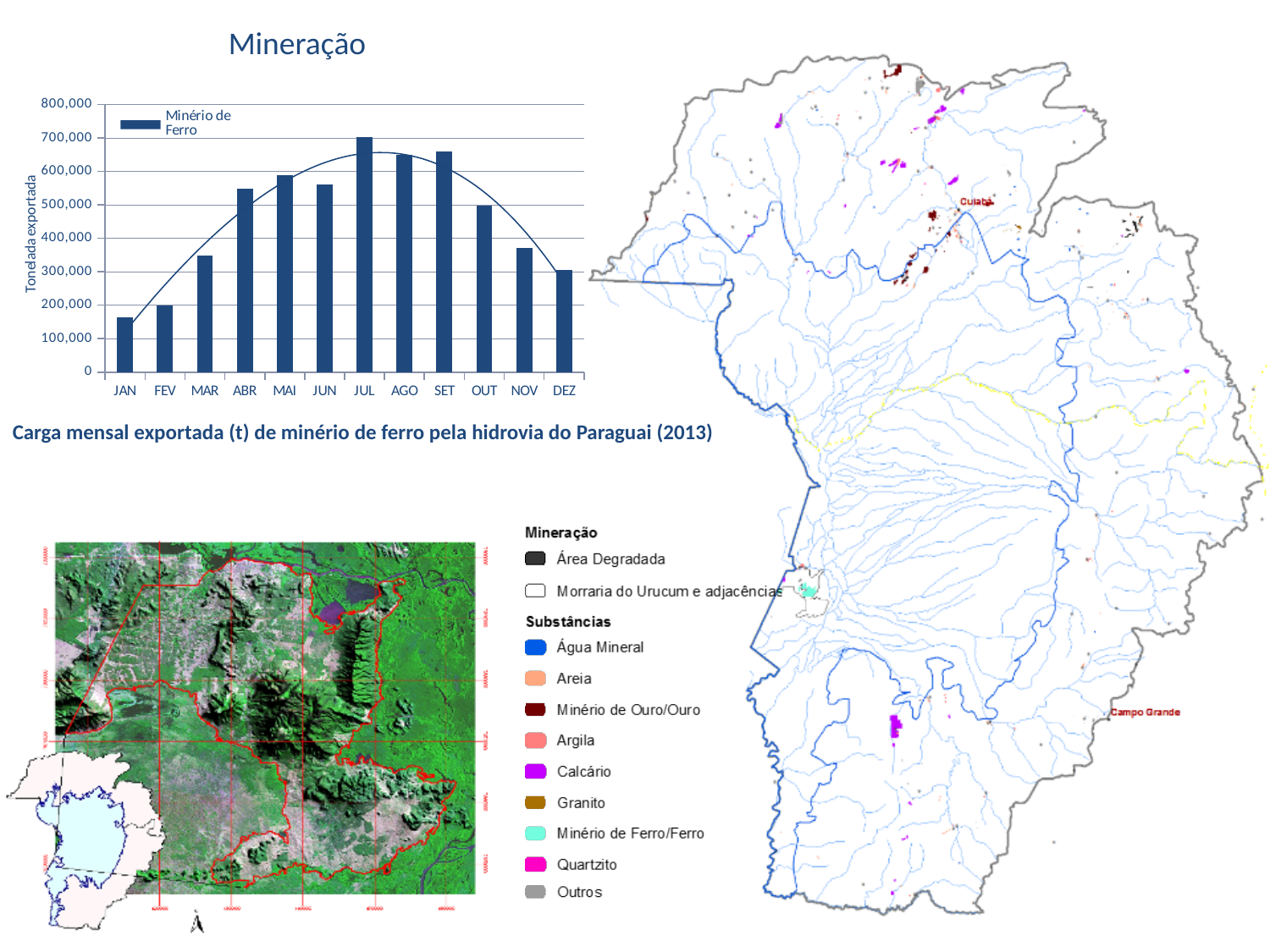
How many series does the legend of the bar chart list? 1 Which month has the larger exported tonnage, MAR or ABR? ABR Which month has the lowest exported tonnage in the bar chart? JAN Is the value for ABR greater or less than 500,000? greater What kind of chart is used to show the monthly exported iron ore cargo? bar chart What is the label on the vertical axis of the bar chart? Tonelada exportada Is the value for JAN greater or less than 200,000? less How many months (categories) are shown on the x axis of the bar chart? 12 How do the values change from JAN to JUL in the bar chart? they rise Is the value for JUL greater or less than 600,000? greater Which month has the highest exported tonnage in the bar chart? JUL